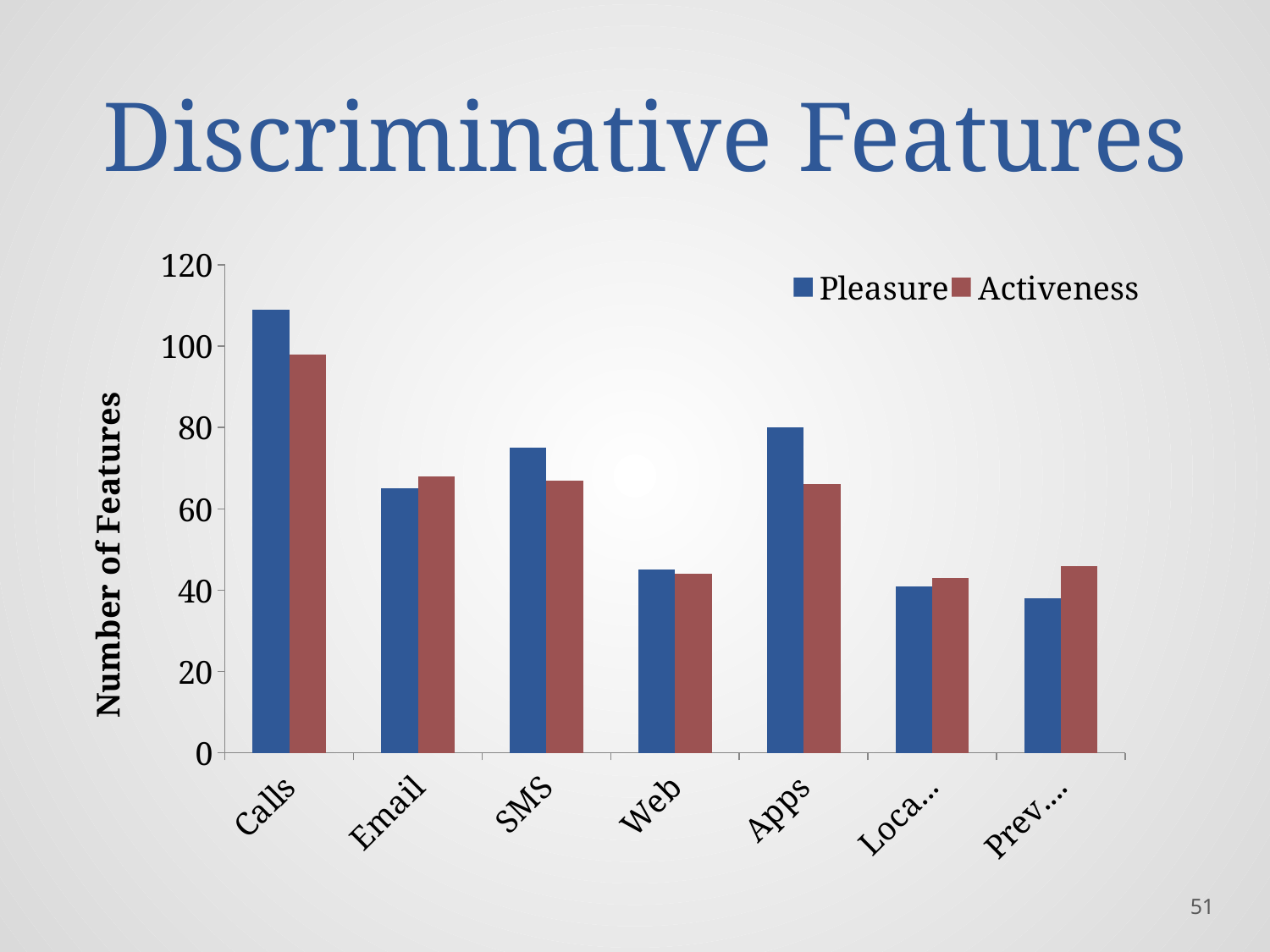
Is the Pleasure value for SMS greater or less than 60? greater Is the Activeness value for Apps greater or less than 80? less Is the Pleasure value for Calls greater or less than 100? greater What kind of chart is shown on the slide? bar chart Which category has the highest Activeness value? Calls Which is larger, the Pleasure value for Apps or the Pleasure value for Email? Apps For Apps, which series has the larger value, Pleasure or Activeness? Pleasure What is the label of the y axis? Number of Features Which category has the highest Pleasure value? Calls How many categories are shown on the x axis? 7 How many series does the legend list? 2